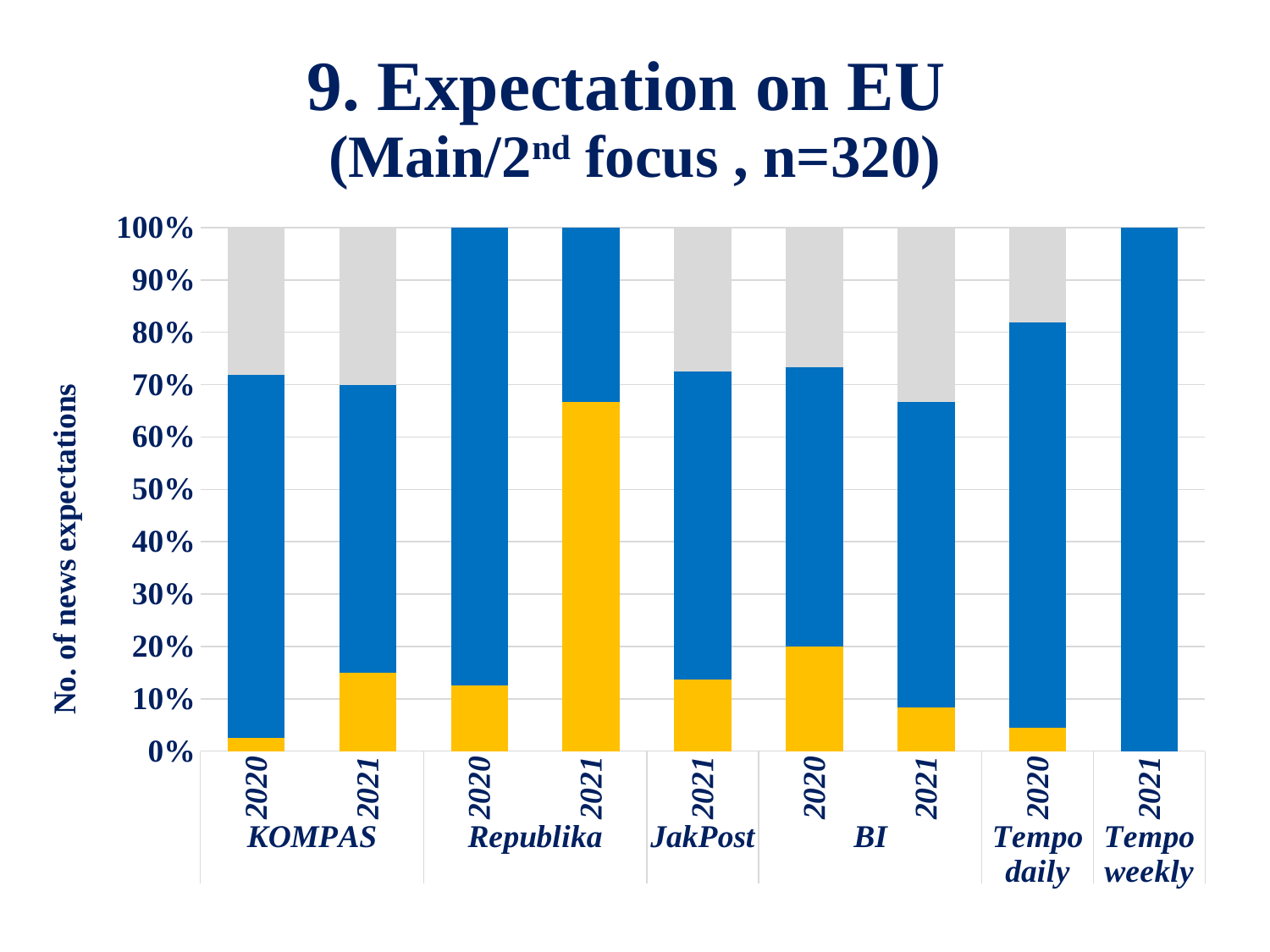
How many news outlets are listed along the x axis of the chart? 6 Which bar has the largest yellow segment? Republika 2021 What kind of chart is shown on the slide? Stacked bar chart Is the yellow segment for BI 2020 greater or less than 10%? greater Does the top of the blue segment for BI 2021 reach greater or less than 70%? less What is the title of the chart on the slide? 9. Expectation on EU (Main/2nd focus , n=320) How many bars are plotted in the chart? 9 What is the label on the vertical axis of the chart? No. of news expectations Is the yellow segment for KOMPAS 2020 greater or less than 10%? less Which bar has no yellow segment at all? Tempo weekly 2021